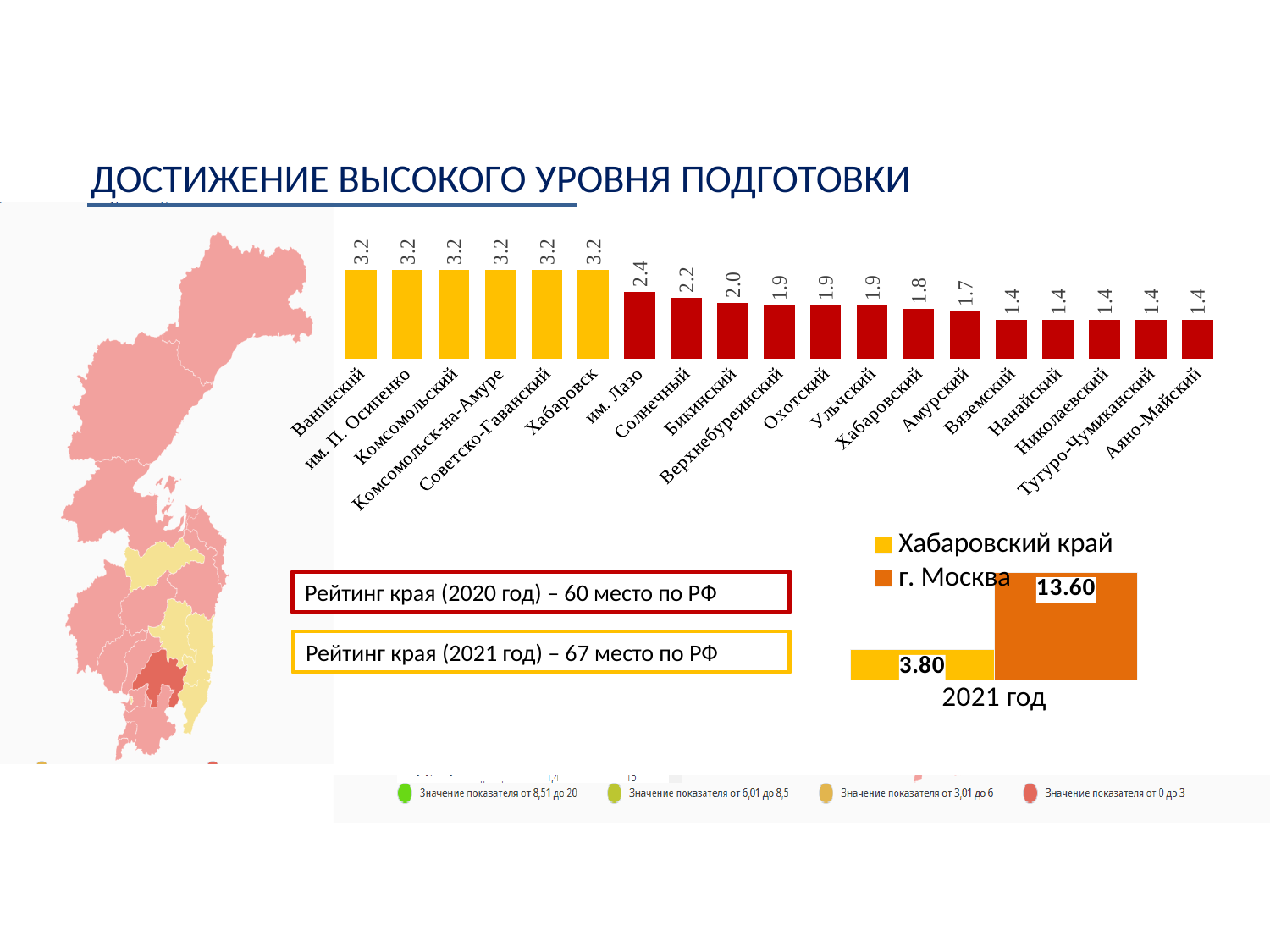
In the bottom-right chart, what is the value for г. Москва in 2021 год? 13.60 In the top bar chart, what is the value for им. Лазо? 2.4 How many categories are shown in the top bar chart? 19 In the top bar chart, what is the difference between the values for Ванинский and Аяно-Майский? 1.8 In the top bar chart, do the values rise or fall from left to right? fall In the bottom-right chart, what is the difference between the values for г. Москва and Хабаровский край? 9.80 In the top bar chart, what is the value for Амурский? 1.7 In the top bar chart, what is the value for Бикинский? 2.0 In the bottom-right chart, what is the value for Хабаровский край in 2021 год? 3.80 In the top bar chart, which is larger, the value for им. Лазо or the value for Хабаровский? им. Лазо In the top bar chart, what is the value for Солнечный? 2.2 How many series does the legend of the bottom-right chart list? 2